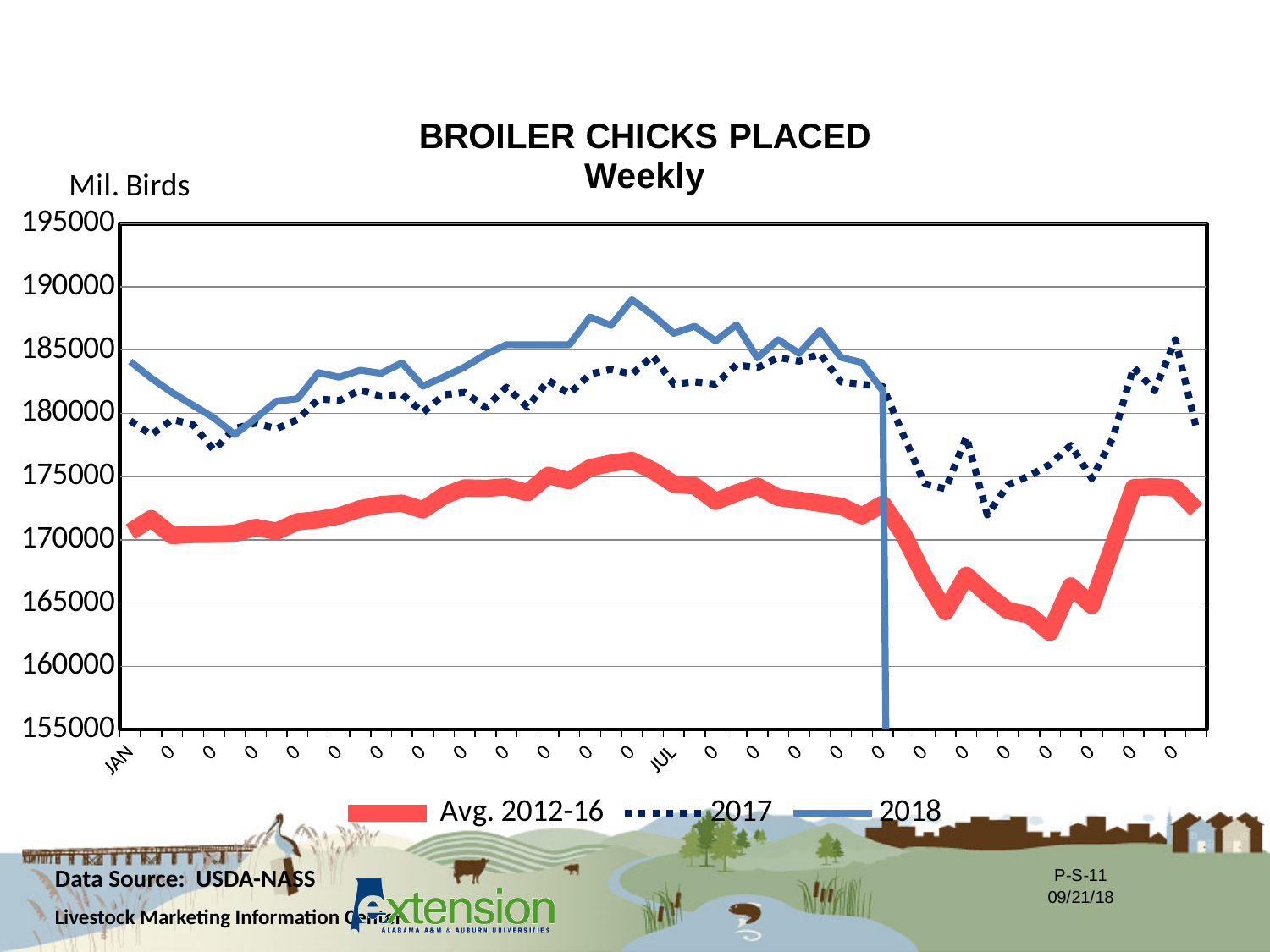
At JUL, which series is higher, 2018 or 2017? 2018 Is the Avg. 2012-16 value at JUL greater or less than 180000? less What are the three series listed in the legend? Avg. 2012-16, 2017, 2018 What kind of chart is shown on the slide? line chart Does the Avg. 2012-16 line generally rise or fall from JAN to JUL? rise Which series has the lowest value at JUL? Avg. 2012-16 How many series does the legend list? 3 What unit label is shown on the y axis? Mil. Birds Is the Avg. 2012-16 value at JAN greater or less than 175000? less At JAN, which series is higher, 2017 or Avg. 2012-16? 2017 Is the 2018 value at JAN greater or less than 180000? greater